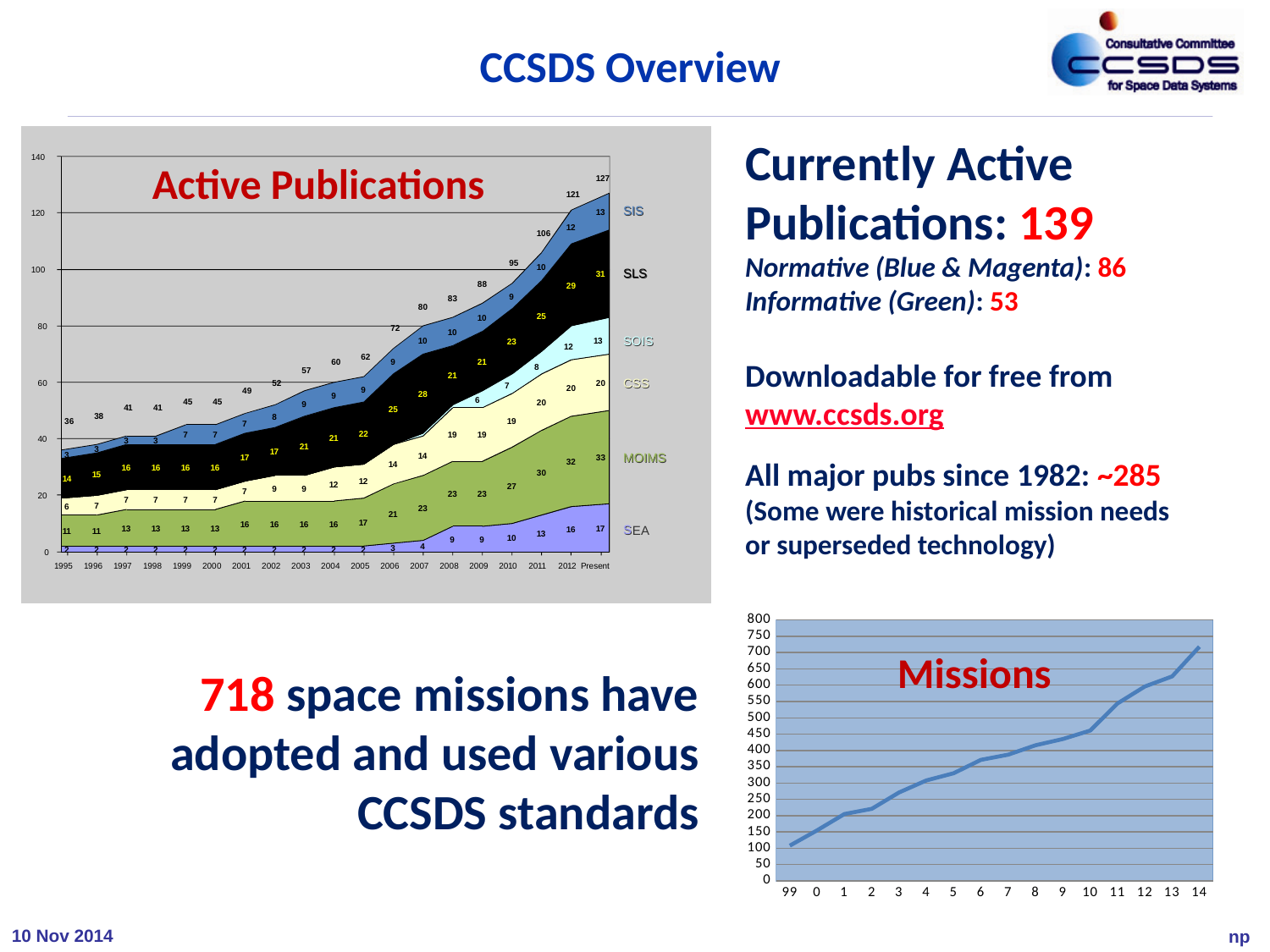
In the Active Publications chart, how many series (areas) are labelled? 6 In the Active Publications chart, what is the difference between the total for 2012 and the total for 2011? 15 In the Active Publications chart, what is the SLS value at Present? 31 In the Active Publications chart, what was the total number of active publications in 2006? 72 In the Active Publications chart, what kind of chart is it? stacked area chart In the Missions chart, what kind of chart is it? line chart In the Missions chart, do the values rise or fall along the x axis? rise In the Missions chart, is the value for 99 greater or less than 150? less In the Active Publications chart, what is the MOIMS value at Present? 33 In the Active Publications chart, which year has the lowest total of active publications? 1995 In the Missions chart, how many points are on the x axis? 16 In the Active Publications chart, which has the larger total, 2007 or 2008? 2008